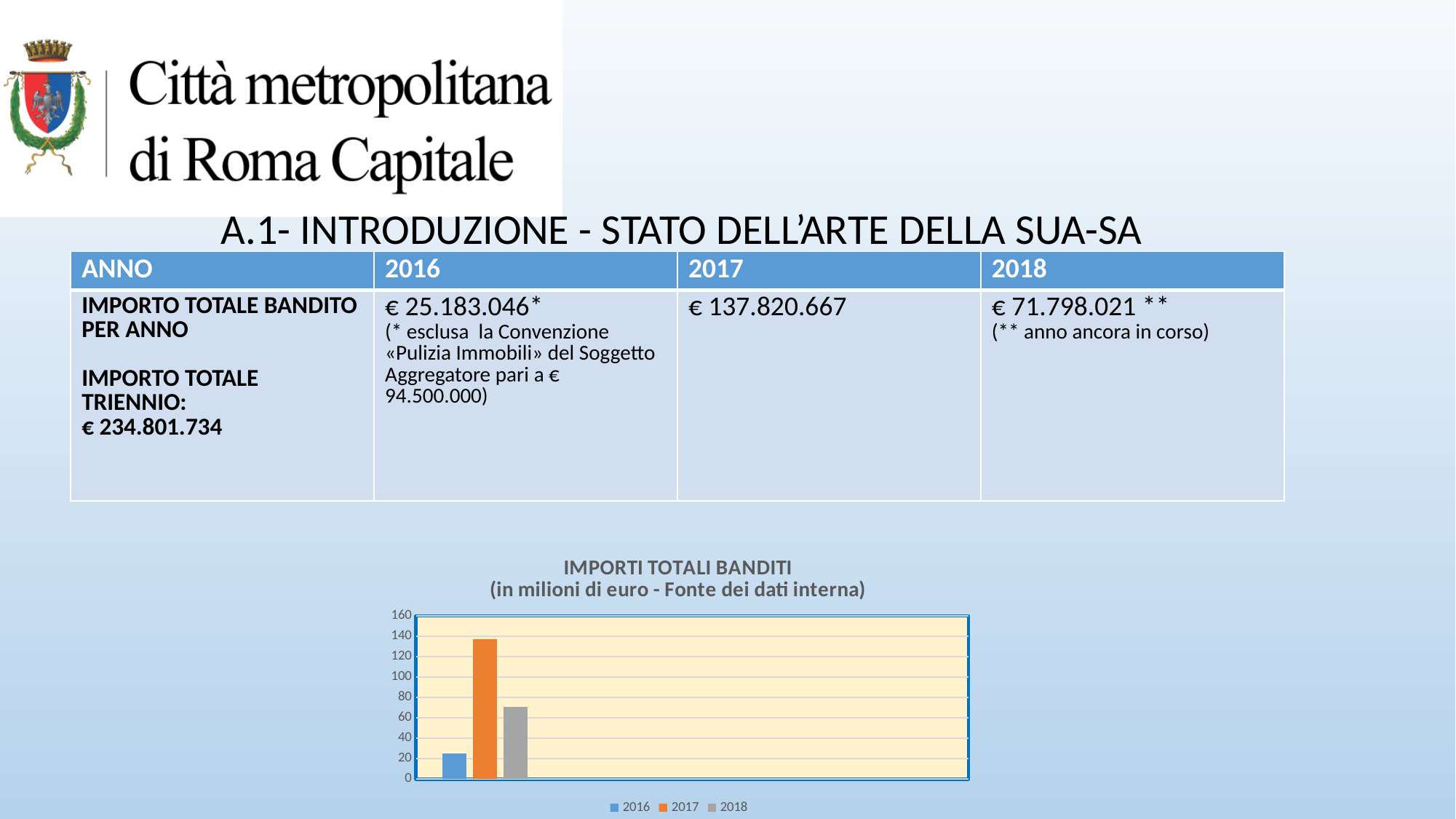
What is the highest value shown on the vertical axis of the 'IMPORTI TOTALI BANDITI' chart? 160 Which year has the lowest bar in the 'IMPORTI TOTALI BANDITI' chart? 2016 In the 'IMPORTI TOTALI BANDITI' chart, is the value for 2018 greater or less than 60? greater In the 'IMPORTI TOTALI BANDITI' chart, is the value for 2018 greater or less than 100? less What kind of chart is shown under the title 'IMPORTI TOTALI BANDITI'? bar chart How many bars are plotted in the 'IMPORTI TOTALI BANDITI' chart? 3 In the 'IMPORTI TOTALI BANDITI' chart, is the value for 2016 greater or less than 40? less In the 'IMPORTI TOTALI BANDITI' chart, is the bar for 2018 larger or smaller than the bar for 2016? larger What colour is the bar for 2017 in the 'IMPORTI TOTALI BANDITI' chart? orange How many series does the legend of the 'IMPORTI TOTALI BANDITI' chart list? 3 Which year has the highest bar in the 'IMPORTI TOTALI BANDITI' chart? 2017